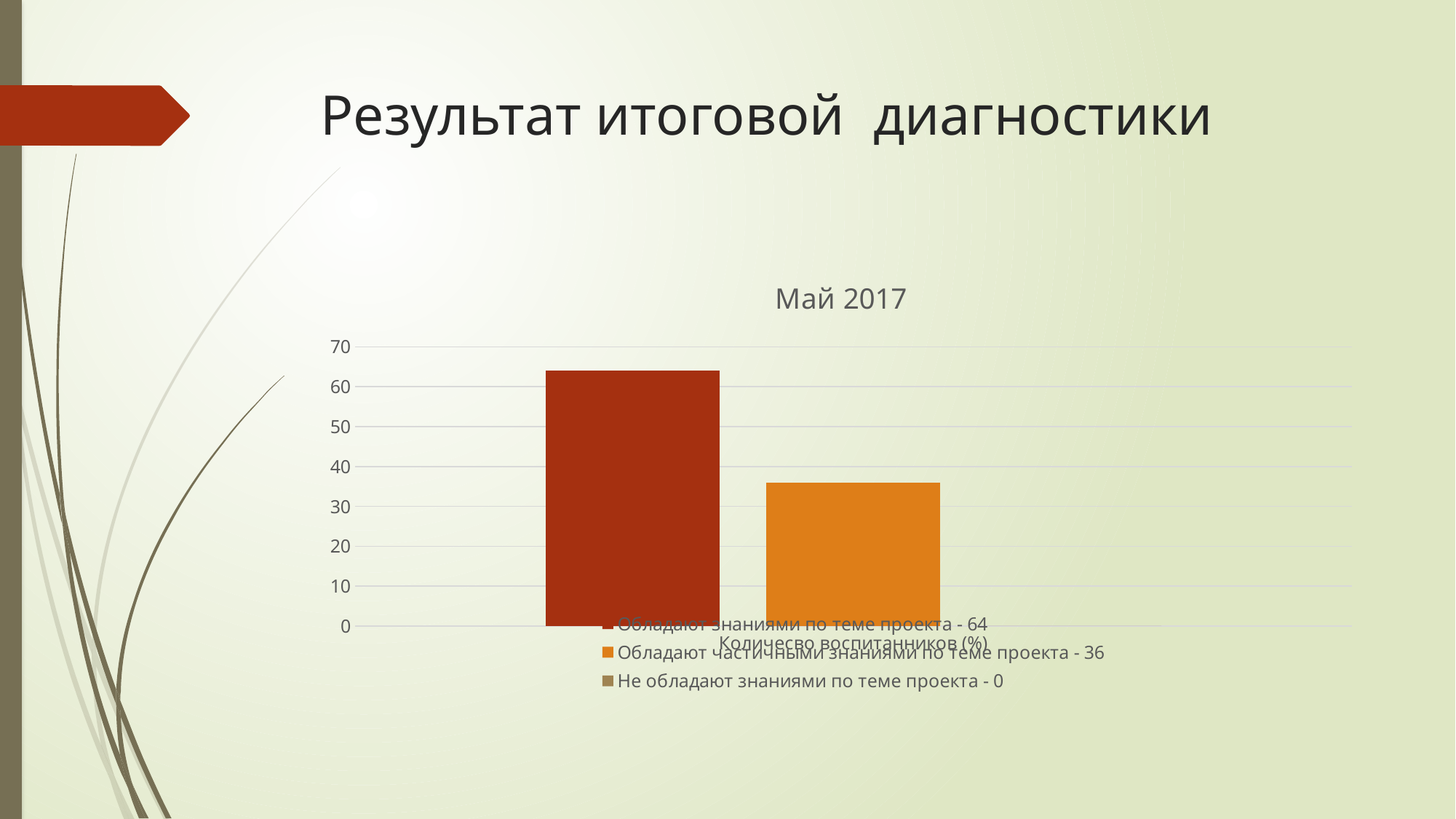
According to the legend, what is the value for "Не обладают знаниями по теме проекта"? 0 According to the legend, what is the value for "Обладают частичными знаниями по теме проекта"? 36 What is the title of the chart? Май 2017 Which series has the highest value? Обладают знаниями по теме проекта Which is larger: the value for "Обладают знаниями по теме проекта" or for "Обладают частичными знаниями по теме проекта"? Обладают знаниями по теме проекта Which series has the lowest value? Не обладают знаниями по теме проекта According to the legend, what is the value for "Обладают знаниями по теме проекта"? 64 What colour is the bar for "Обладают частичными знаниями по теме проекта"? orange What is the difference between the values for "Обладают знаниями по теме проекта" and "Обладают частичными знаниями по теме проекта"? 28 Is the value for "Обладают частичными знаниями по теме проекта" greater or less than 40? less How many series does the chart legend list? 3 What kind of chart is shown on the slide? bar chart